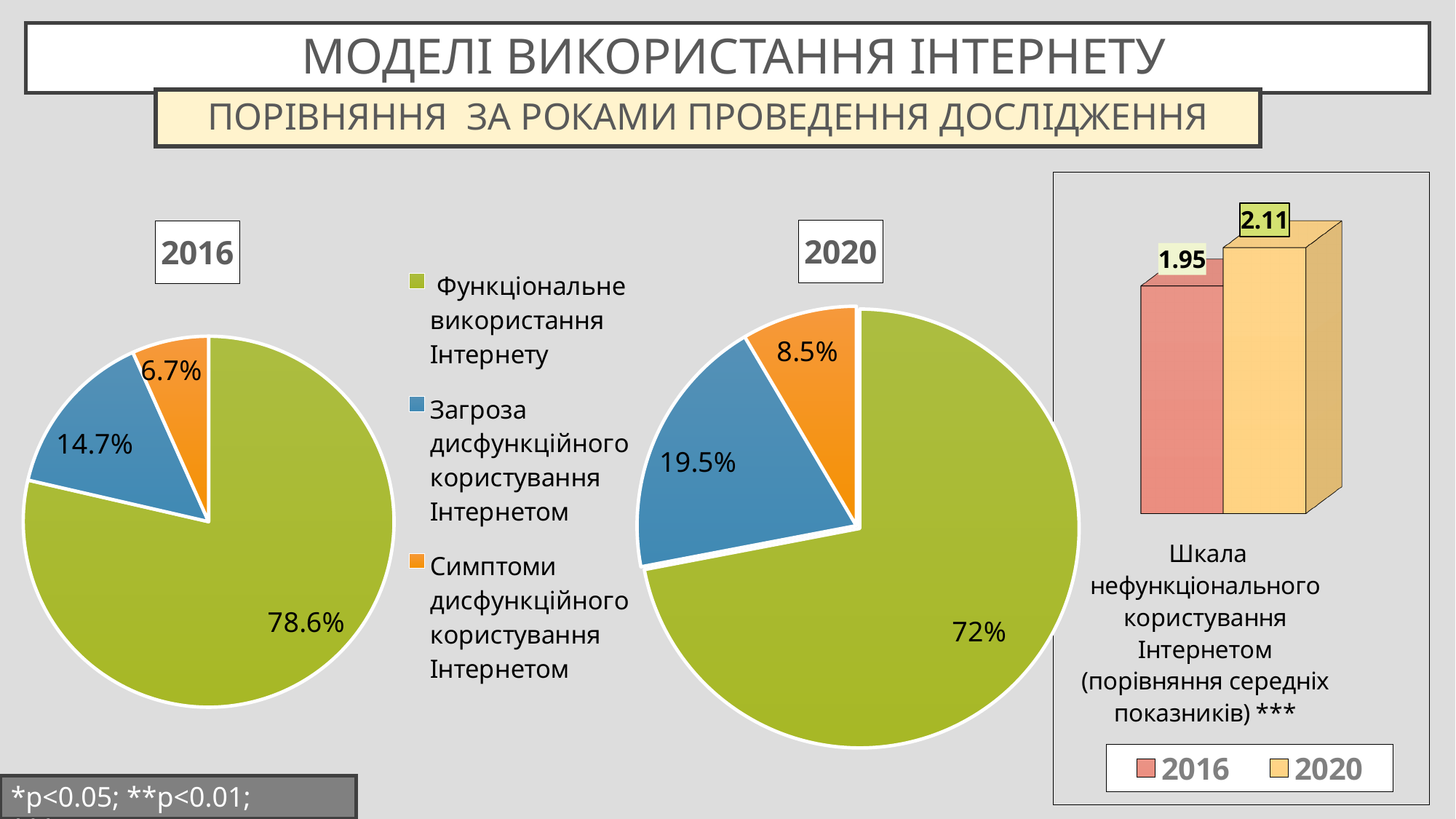
In the bar chart on the right ('Шкала нефункціонального користування Інтернетом'), what is the value for 2020? 2.11 In the 2020 pie chart, what share is labelled for the slice 'Загроза дисфункційного користування Інтернетом'? 19.5% Which is larger: the 'Функціональне використання Інтернету' share in the 2016 pie chart or in the 2020 pie chart? 2016 What is the difference between the 'Загроза дисфункційного користування Інтернетом' share in 2020 and in 2016? 4.8% In the 2016 pie chart, what share is labelled for the slice 'Симптоми дисфункційного користування Інтернетом'? 6.7% In the 2016 pie chart, what share is labelled for the slice 'Функціональне використання Інтернету'? 78.6% What type of chart is the chart on the right of the slide ('Шкала нефункціонального користування Інтернетом')? Bar chart How many series does the legend of the bar chart on the right list? 2 In the 2020 pie chart, which slice is the smallest? Симптоми дисфункційного користування Інтернетом How many slices does the 2020 pie chart have? 3 In the 2016 pie chart, which slice is the largest? Функціональне використання Інтернету In the bar chart on the right ('Шкала нефункціонального користування Інтернетом'), what is the difference between the 2020 and 2016 values? 0.16